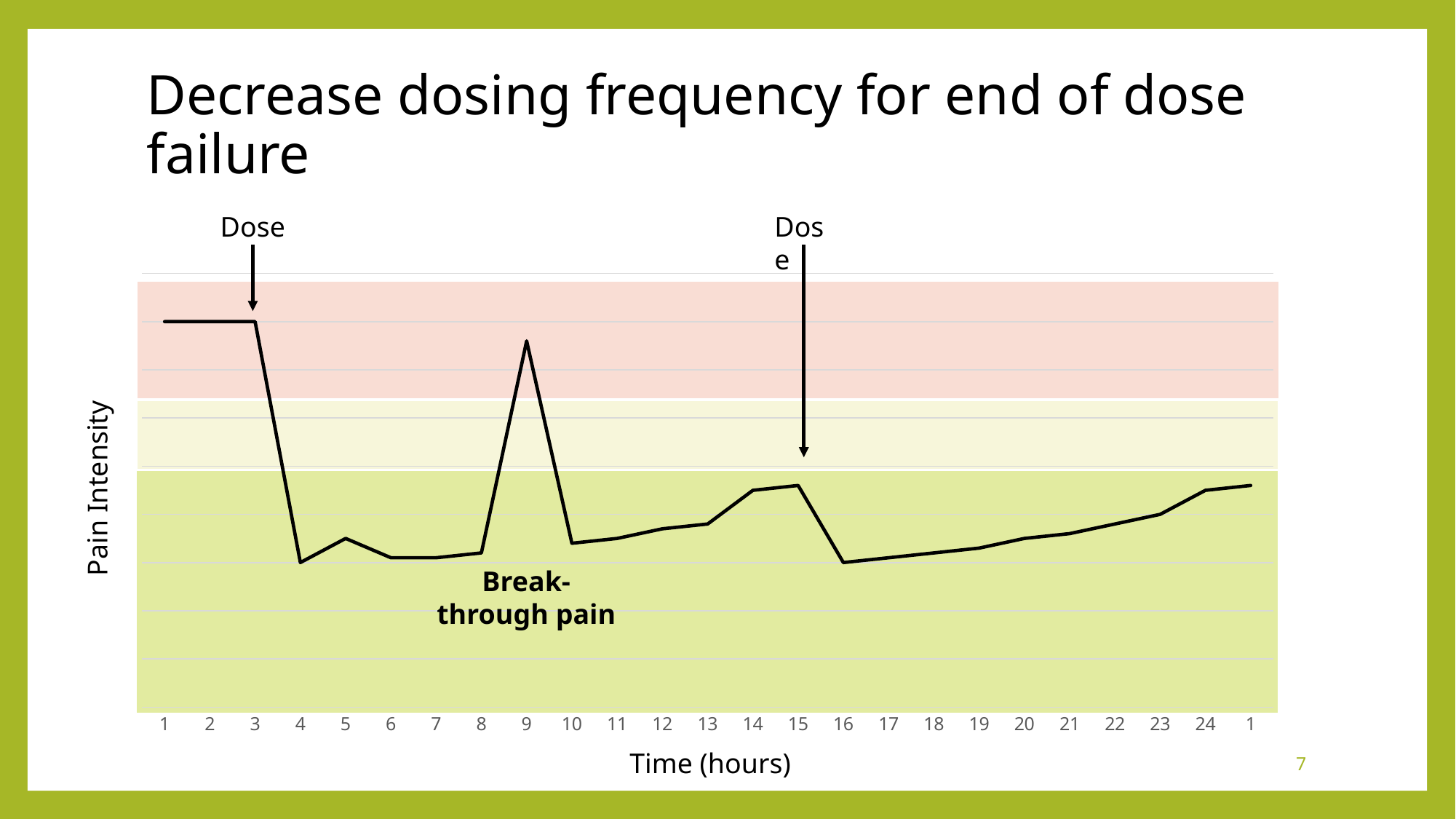
What is the title of the x axis of the chart? Time (hours) Does pain intensity rise or fall between hour 15 and hour 16? fall Does pain intensity rise or fall between hour 3 and hour 4? fall Does pain intensity rise or fall between hour 8 and hour 9? rise How many time points are labelled along the x axis of the chart? 25 Is pain intensity higher at hour 14 or at hour 16? hour 14 Is pain intensity higher at hour 1 or at hour 4? hour 1 Is pain intensity higher at hour 9 or at hour 15? hour 9 What kind of chart is shown on the slide? line chart What is the title of the y axis of the chart? Pain Intensity